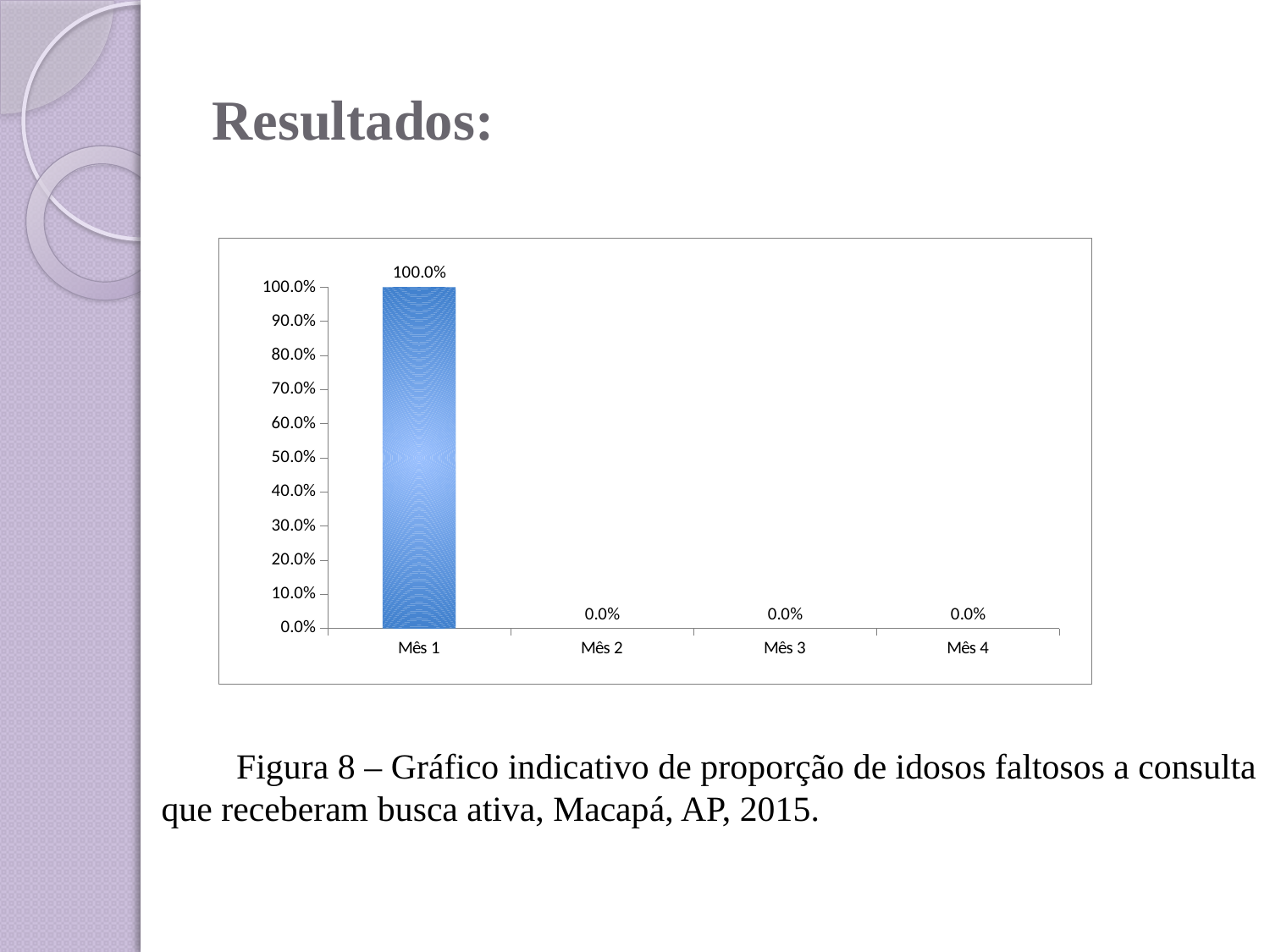
What is the value for Mês 4? 0.0% How many categories are shown on the x axis? 4 Which month has the highest value? Mês 1 Is the value for Mês 1 greater or less than 50.0%? greater Do the values rise or fall from Mês 1 to Mês 2? fall What is the highest tick value shown on the y axis? 100.0% What colour is the bar for Mês 1? blue What kind of chart is shown on the slide? bar chart What is the value for Mês 1? 100.0% What is the difference between the values for Mês 1 and Mês 3? 100.0% What is the value for Mês 2? 0.0% Which is larger, the value for Mês 1 or the value for Mês 2? Mês 1